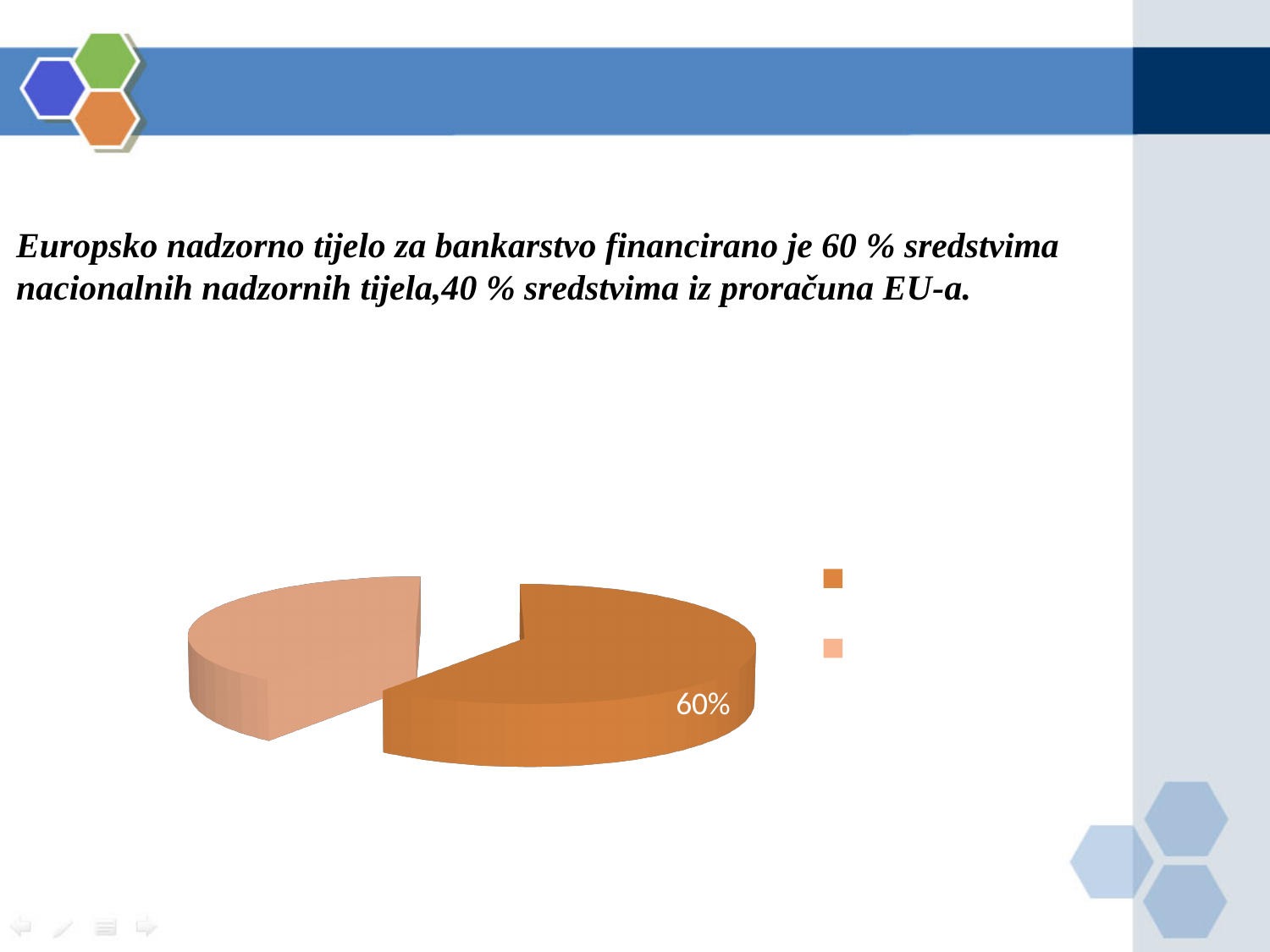
Is the pie chart drawn in 3D or flat 2D? 3D Which slice of the pie chart is the smallest? the lighter peach slice What kind of chart is shown on the slide? pie chart Is the share of the darker orange slice greater or less than 50%? greater Which slice of the pie chart is the largest? the darker orange slice labelled 60% How many slices does the pie chart have? 2 Which slice of the pie chart is larger, the darker orange slice or the lighter peach slice? the darker orange slice Which slice of the pie chart carries a printed data label? the darker orange slice How many entries does the legend of the pie chart list? 2 Is the share of the lighter peach slice greater or less than 50%? less What percentage is printed on the darker orange slice of the pie chart? 60%